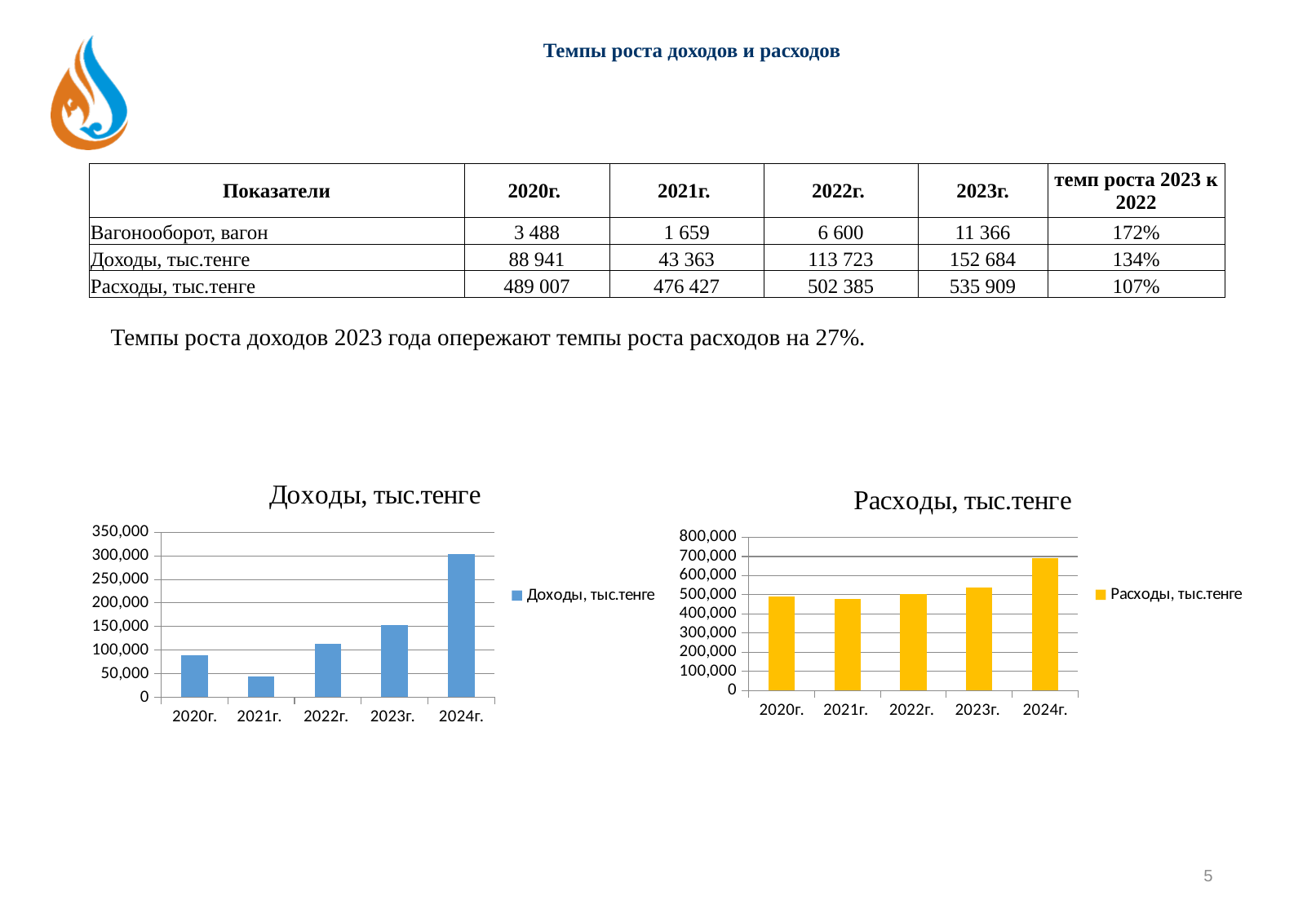
In the "Доходы, тыс.тенге" chart, is the value for 2021г. greater or less than 50,000? less In the "Расходы, тыс.тенге" chart, is the value for 2021г. greater or less than 500,000? less What kind of chart is the "Доходы, тыс.тенге" chart? bar chart In the "Доходы, тыс.тенге" chart, do the values rise or fall from 2021г. to 2024г.? rise How many series does the legend of the "Расходы, тыс.тенге" chart list? 1 In the "Расходы, тыс.тенге" chart, which year has the highest value? 2024г. In the "Доходы, тыс.тенге" chart, which year has the lowest value? 2021г. In the "Расходы, тыс.тенге" chart, which is larger, the value for 2021г. or the value for 2023г.? 2023г. In the "Доходы, тыс.тенге" chart, which year has the highest value? 2024г. In the "Расходы, тыс.тенге" chart, is the value for 2024г. greater or less than 600,000? greater How many year categories are shown on the x axis of the "Расходы, тыс.тенге" chart? 5